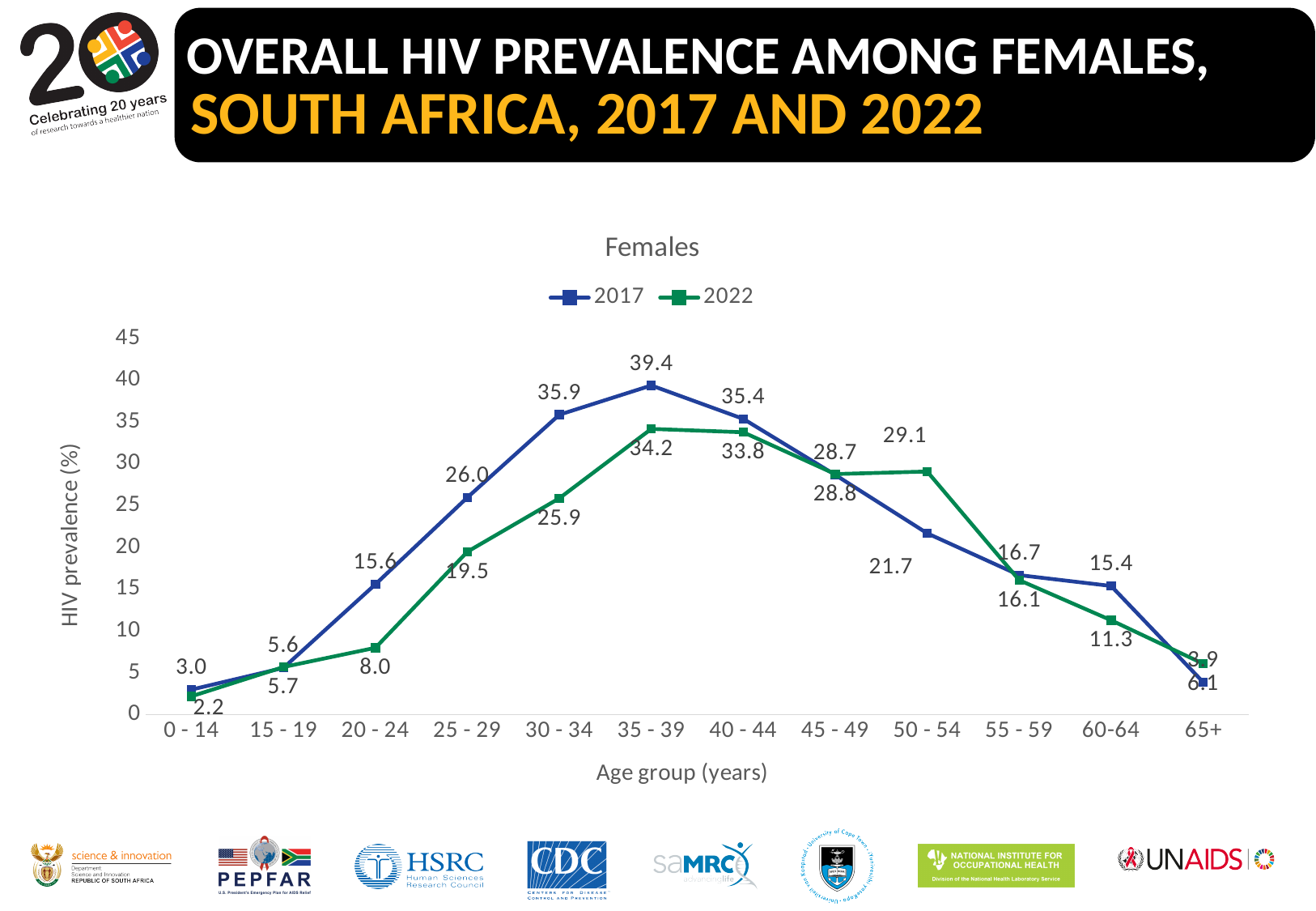
What kind of chart is shown on the slide? line chart For the 50 - 54 age group, which year has the higher HIV prevalence, 2017 or 2022? 2022 Which age group has the lowest HIV prevalence in the 2022 series? 0 - 14 What is the 2022 HIV prevalence for the 20 - 24 age group? 8.0 How many series does the legend list? 2 Which age group has the highest HIV prevalence in the 2017 series? 35 - 39 Is the 2022 value for the 60-64 age group greater or less than 10? greater What is the 2022 HIV prevalence for the 45 - 49 age group? 28.8 What is the 2017 HIV prevalence for the 35 - 39 age group? 39.4 What is the difference between the 2017 and 2022 HIV prevalence for the 30 - 34 age group? 10.0 Does the 2017 series rise or fall from the 35 - 39 age group to the 60-64 age group? fall How many age groups are shown on the x axis? 12